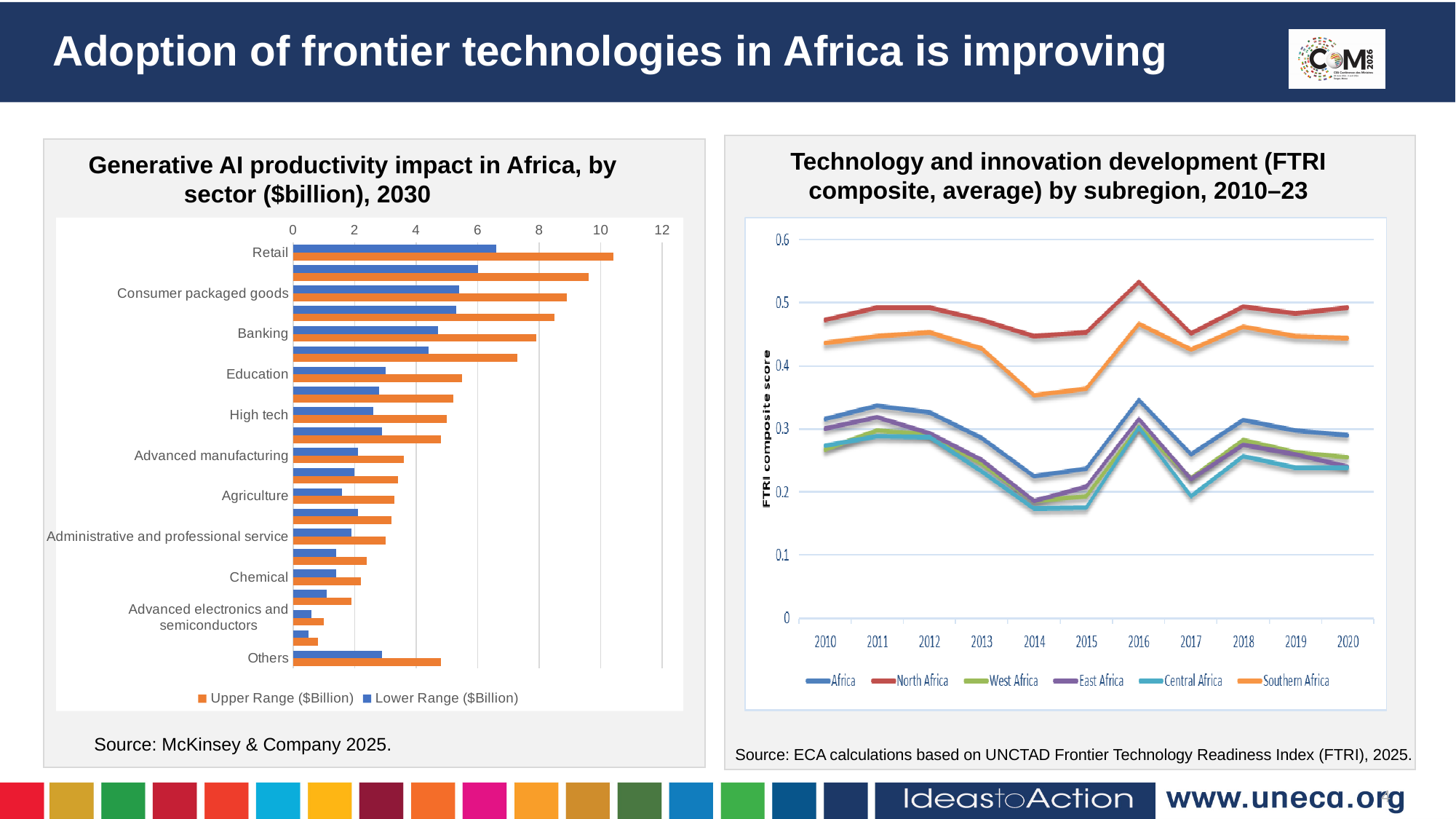
In the right chart, is the value for Southern Africa in 2014 greater or less than 0.4? less In the left chart, which has the larger Upper Range value, Retail or Banking? Retail What kind of chart is the left chart, 'Generative AI productivity impact in Africa, by sector ($billion), 2030'? Bar chart In the right chart, how many series does the legend list? 6 In the left chart, is the Upper Range value for Retail greater or less than 10? greater In the right chart, does the Africa line rise or fall from 2012 to 2014? Fall What kind of chart is the right chart, 'Technology and innovation development (FTRI composite, average) by subregion, 2010–23'? Line chart In the left chart, how many series does the legend list? 2 In the right chart, which subregion has the highest FTRI composite score across the whole period? North Africa In the right chart, how many years are shown on the x axis? 11 In the right chart, is the value for North Africa in 2016 greater or less than 0.5? greater In the right chart, which subregion has the lowest FTRI composite score in 2017? Central Africa